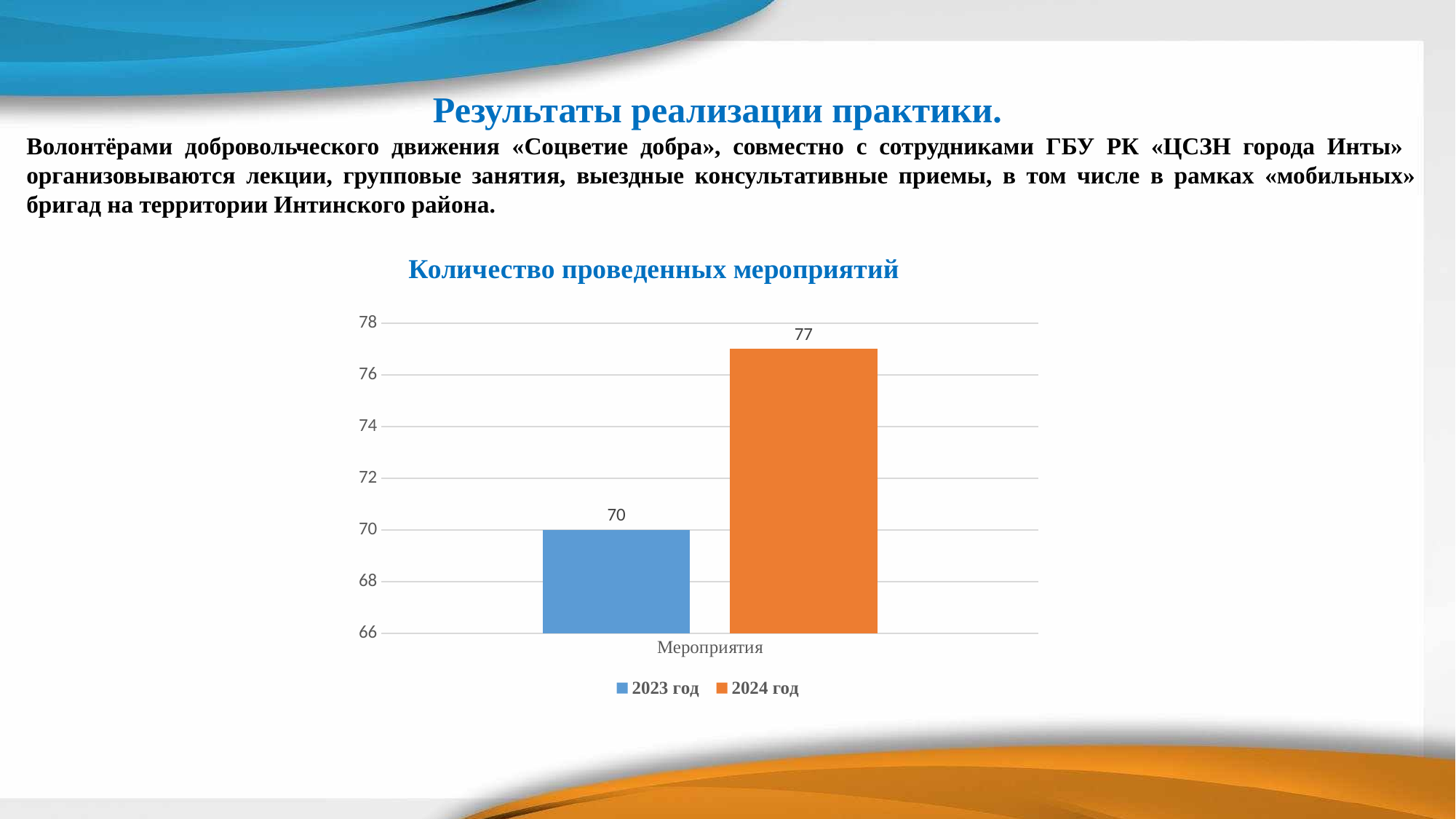
What is the value for 2023 год in the chart? 70 What is the title of the chart? Количество проведенных мероприятий What is the difference between the 2024 год value and the 2023 год value? 7 Is the value for 2023 год greater or less than 72? less Which series has the higher value, 2023 год or 2024 год? 2024 год How many series does the legend list? 2 What kind of chart is shown on the slide? bar chart Is the value for 2024 год greater or less than 76? greater Which series has the lower value in the chart? 2023 год Did the number of events rise or fall from 2023 год to 2024 год? rise What is the category label on the x axis of the chart? Мероприятия What is the value for 2024 год in the chart? 77